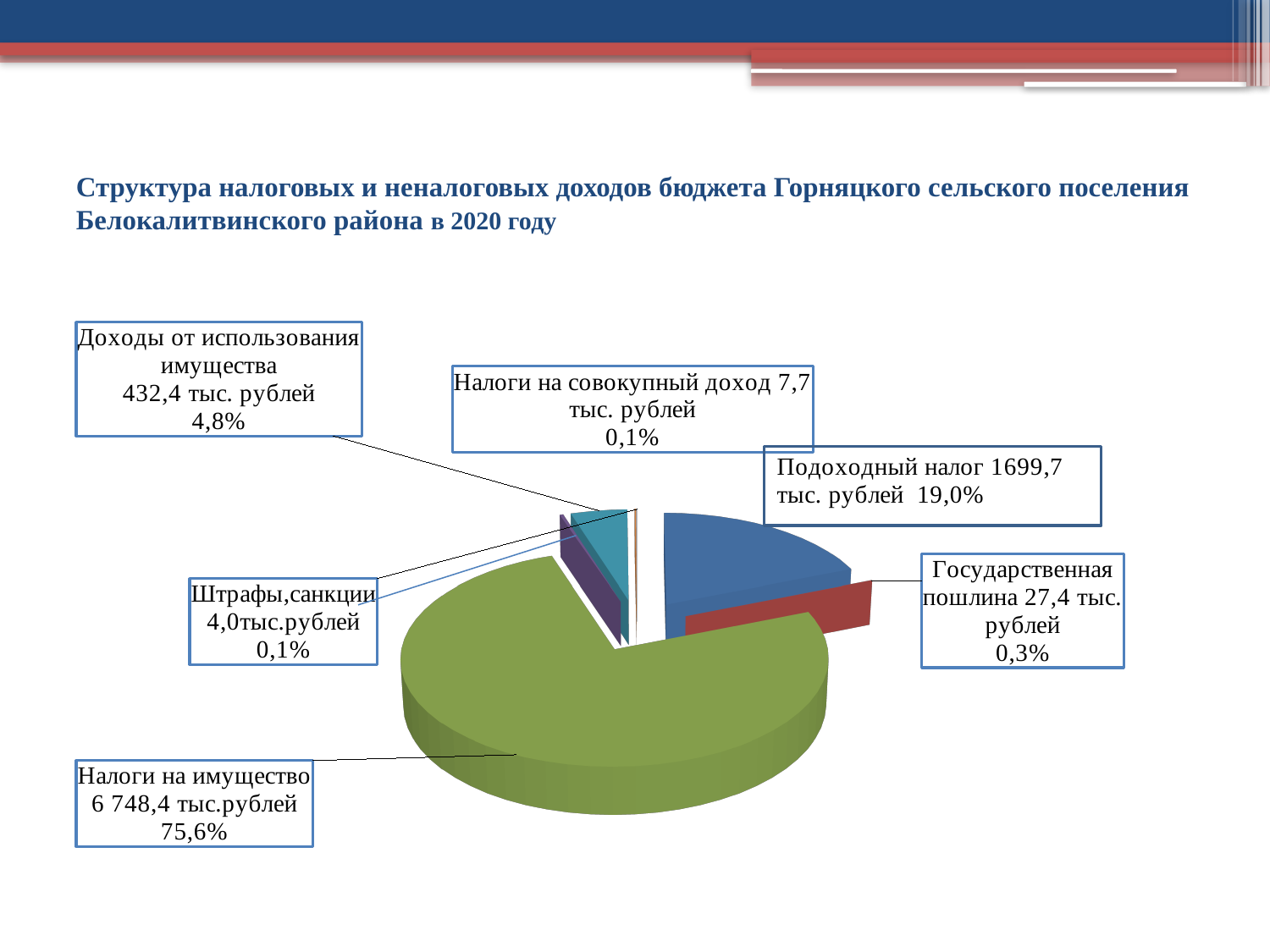
What is the value for Подоходный налог? 1699,7 тыс. рублей What share of the pie does Доходы от использования имущества represent? 4,8% What share of the pie does Подоходный налог represent? 19,0% What year does the chart title refer to? 2020 Which category has the smallest value in тыс. рублей? Штрафы,санкции What is the value for Налоги на имущество? 6 748,4 тыс.рублей Which category has the largest share of the pie? Налоги на имущество What is the difference between the values for Налоги на имущество and Подоходный налог, in тыс. рублей? 5 048,7 Which is larger: the value for Государственная пошлина or the value for Налоги на совокупный доход? Государственная пошлина What is the value for Государственная пошлина? 27,4 тыс. рублей What kind of chart is shown on the slide? pie chart